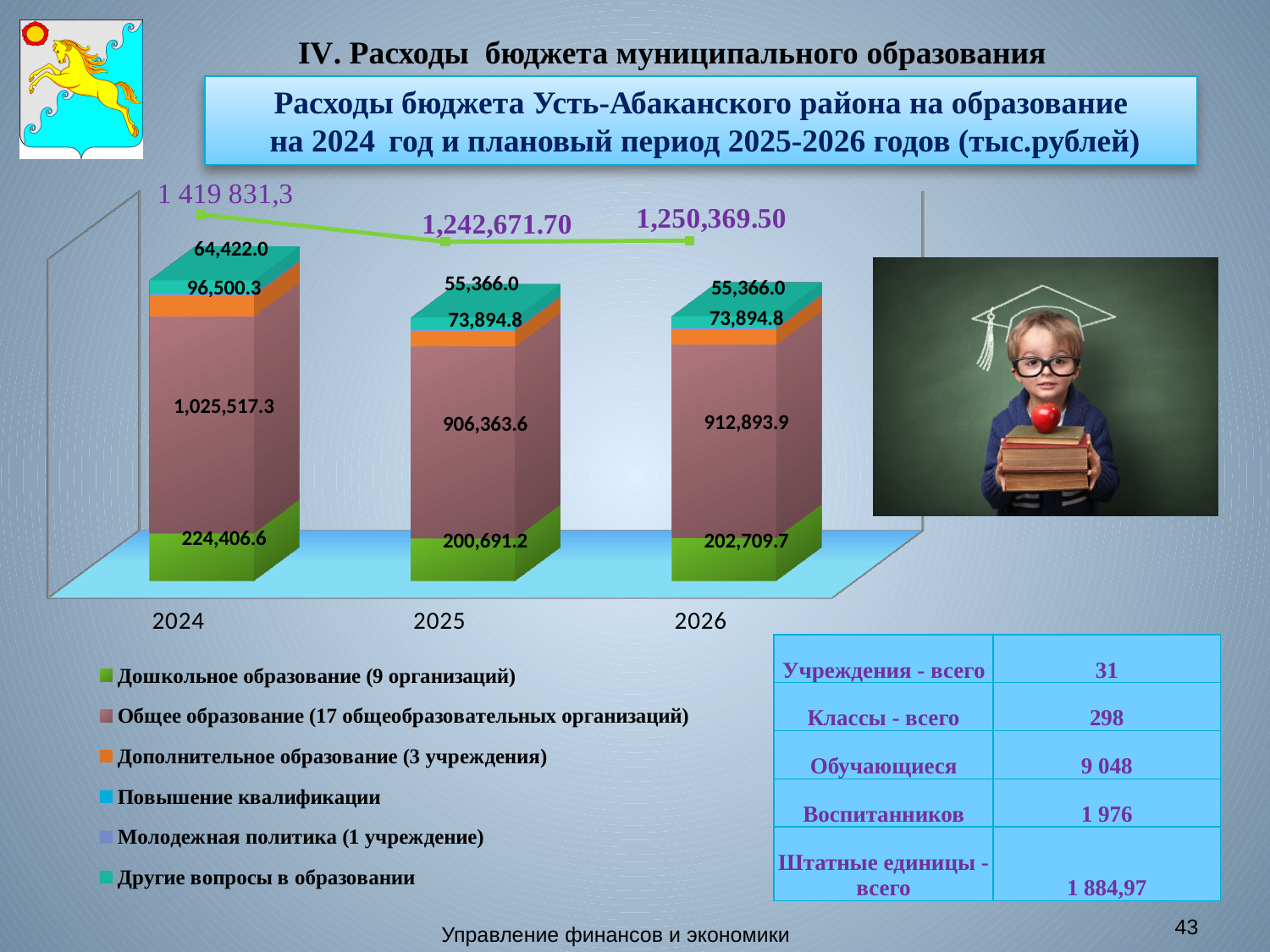
What kind of chart is shown? Stacked bar chart What is the value for Общее образование in 2025? 906,363.6 What is the total education expenditure shown for 2024? 1 419 831,3 Which year has the lowest value for Дошкольное образование? 2025 Which year has the highest value for Общее образование? 2024 What is the value for Дополнительное образование in 2026? 73,894.8 What is the value for Дошкольное образование in 2024? 224,406.6 Is the value for Общее образование larger in 2026 or in 2025? 2026 What is the total education expenditure shown for 2026? 1,250,369.50 How many years are shown on the x axis? 3 How many series does the legend list? 6 What is the difference between the Дошкольное образование values for 2024 and 2025? 23,715.4